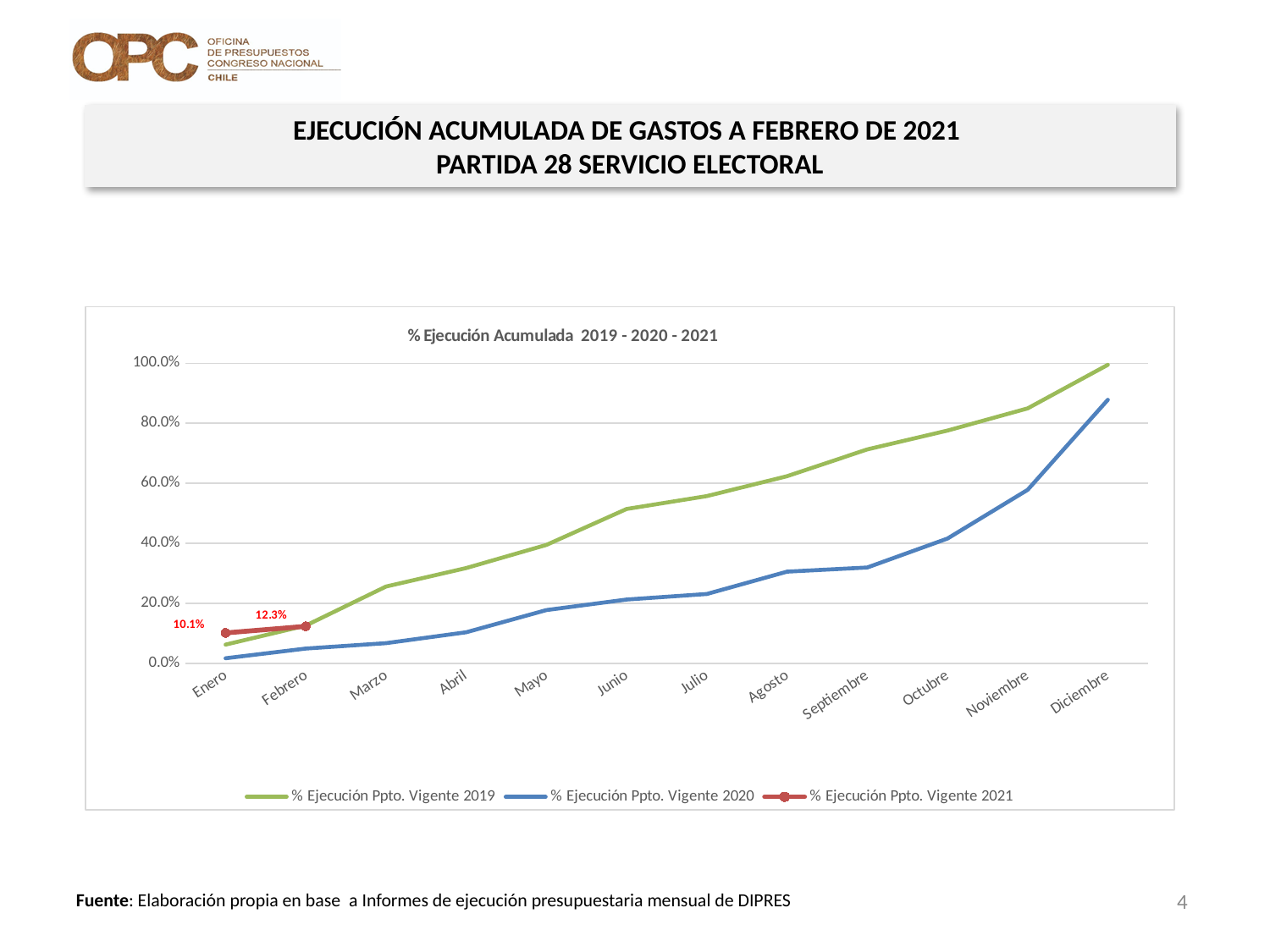
How many series does the chart legend list? 3 In which month does the % Ejecución Ppto. Vigente 2019 series reach its highest value? Diciembre What is the value of % Ejecución Ppto. Vigente 2021 for Febrero? 12.3% Does the % Ejecución Ppto. Vigente 2019 line rise or fall from Enero to Diciembre? Rise In Diciembre, which series is higher: % Ejecución Ppto. Vigente 2019 or % Ejecución Ppto. Vigente 2020? % Ejecución Ppto. Vigente 2019 Is the value for % Ejecución Ppto. Vigente 2020 in Junio greater or less than 40%? less How many months are shown on the x axis of the chart? 12 Is the value for % Ejecución Ppto. Vigente 2019 in Diciembre greater or less than 80%? greater What is the value of % Ejecución Ppto. Vigente 2021 for Enero? 10.1% By how much did % Ejecución Ppto. Vigente 2021 increase from Enero to Febrero? 2.2% What is the title of the chart? % Ejecución Acumulada 2019 - 2020 - 2021 What kind of chart is shown on the slide? Line chart